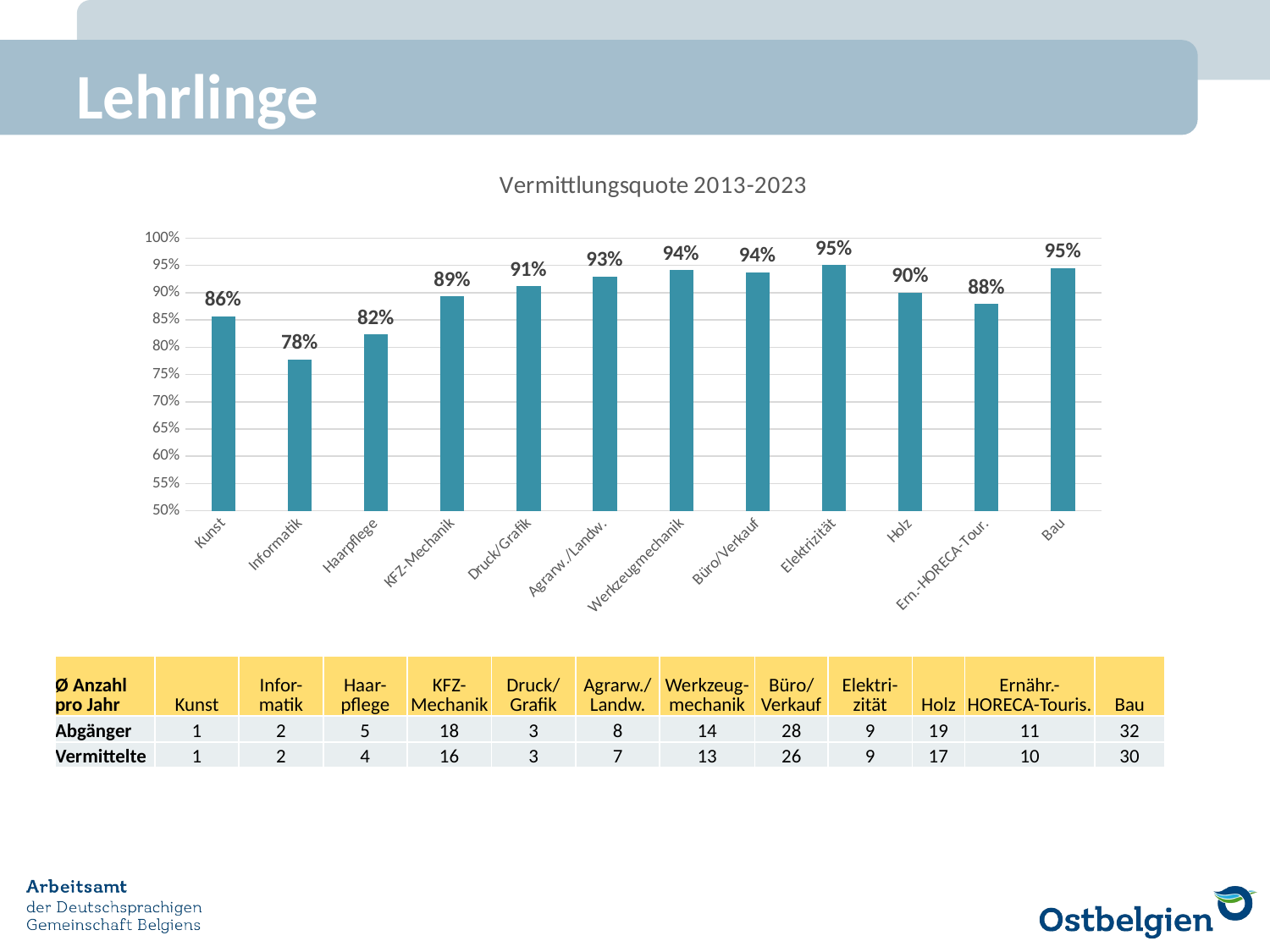
Is the value for Haarpflege greater or less than 85%? less What type of chart is shown on the slide? bar chart Which has a higher Vermittlungsquote, Agrarw./Landw. or Holz? Agrarw./Landw. What is the difference between the Vermittlungsquote for Druck/Grafik and for Haarpflege? 9% What is the Vermittlungsquote for Ern.-HORECA-Tour.? 88% Which category has the lowest Vermittlungsquote? Informatik What is the title of the chart? Vermittlungsquote 2013-2023 What is the Vermittlungsquote for Holz? 90% What is the Vermittlungsquote for KFZ-Mechanik? 89% What is the difference between the Vermittlungsquote for Elektrizität and for Kunst? 9% What is the Vermittlungsquote for Informatik? 78% How many categories are shown in the chart? 12